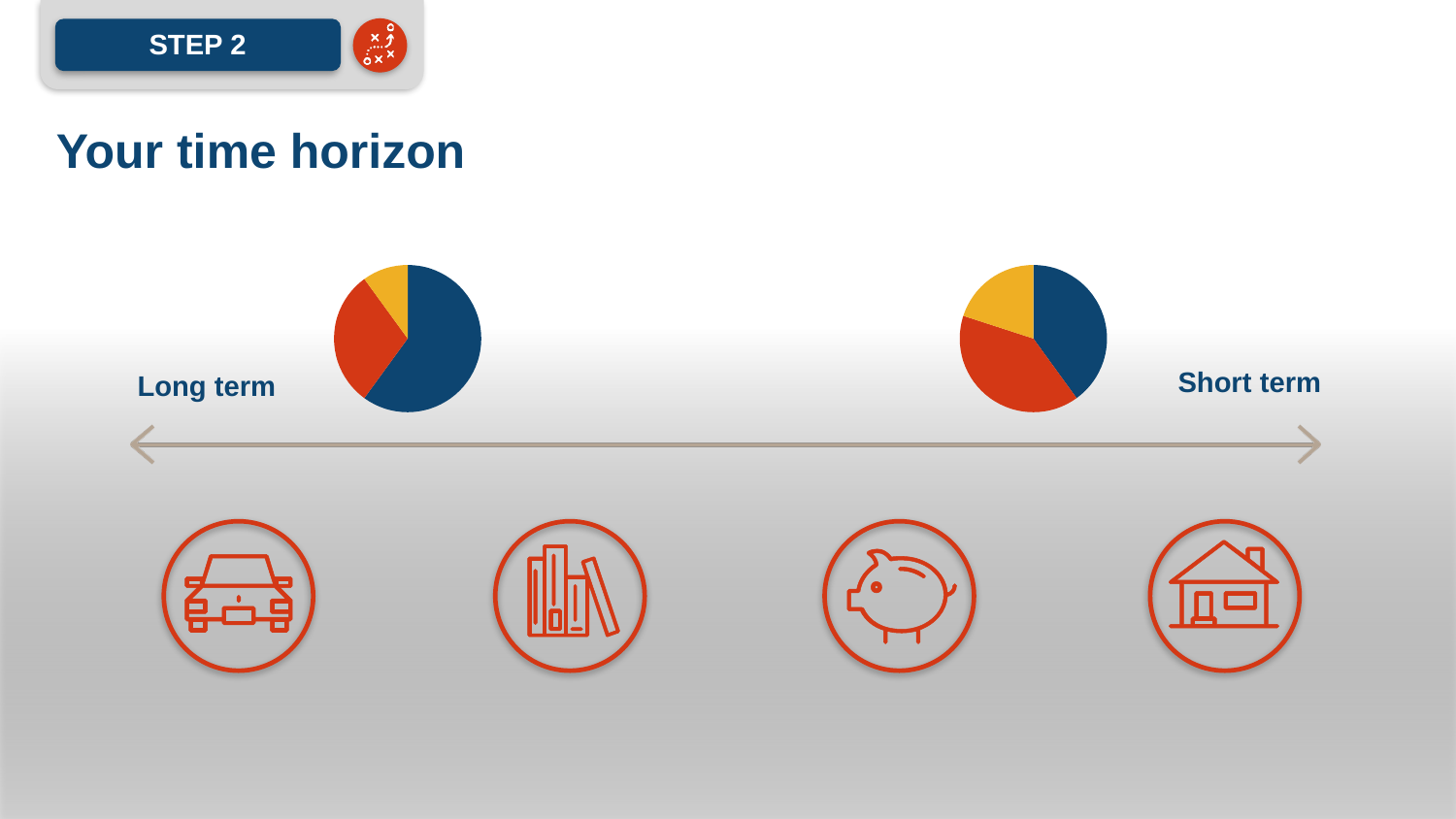
Is the dark blue slice larger in the pie chart next to 'Long term' or in the pie chart next to 'Short term'? Long term What kind of chart is the chart next to the 'Long term' label? pie chart Is the yellow slice larger in the pie chart next to 'Long term' or in the pie chart next to 'Short term'? Short term In the pie chart next to 'Short term', which colour slice is the smallest? yellow How many slices does the pie chart next to 'Short term' have? 3 What kind of chart is the chart next to the 'Short term' label? pie chart In the pie chart next to 'Long term', which colour slice is the largest? dark blue How many slices does the pie chart next to 'Long term' have? 3 What three colours are used for the slices in the pie charts? dark blue, red and yellow In the pie chart next to 'Long term', which is larger: the dark blue slice or the red slice? dark blue How many pie charts are shown on the slide? 2 In the pie chart next to 'Long term', which colour slice is the smallest? yellow